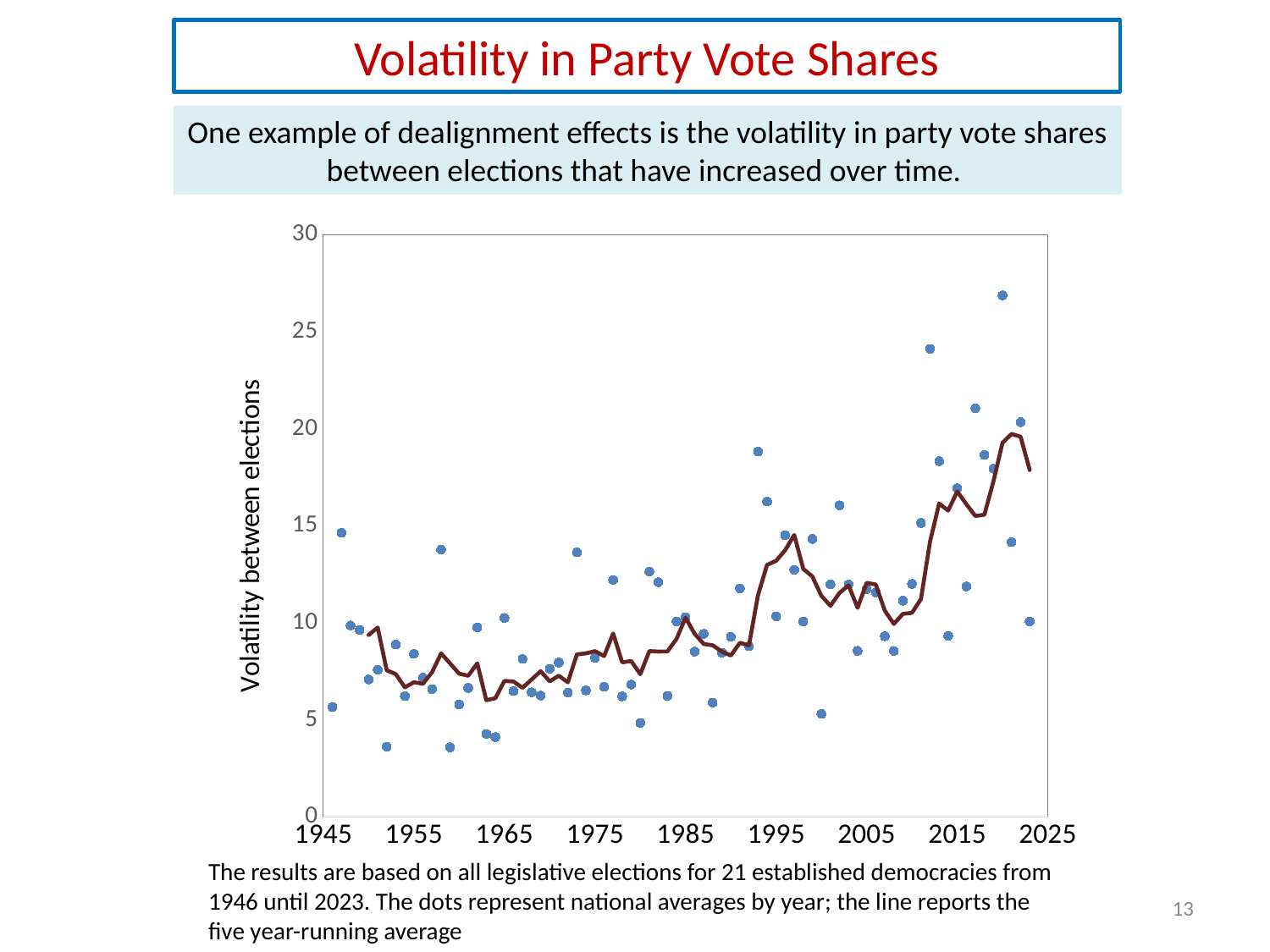
Which is larger: the running-average line's value around 2015 or its value around 1955? Around 2015 Is the value of the highest dot on the chart greater or less than 25? greater Is the value of the running-average line around 2020 greater or less than 15? greater In roughly which decade does the highest dot on the chart appear? 2015–2025 What is the label of the vertical axis of the chart? Volatility between elections Is the value of the running-average line around 1975 greater or less than 15? less What is the title of the chart on the slide? Volatility in Party Vote Shares Overall, does the five-year running average line rise or fall from 1945 to 2025? Rise What is the highest value shown on the vertical axis? 30 What kind of chart is shown on the slide? Scatter chart with a running-average line